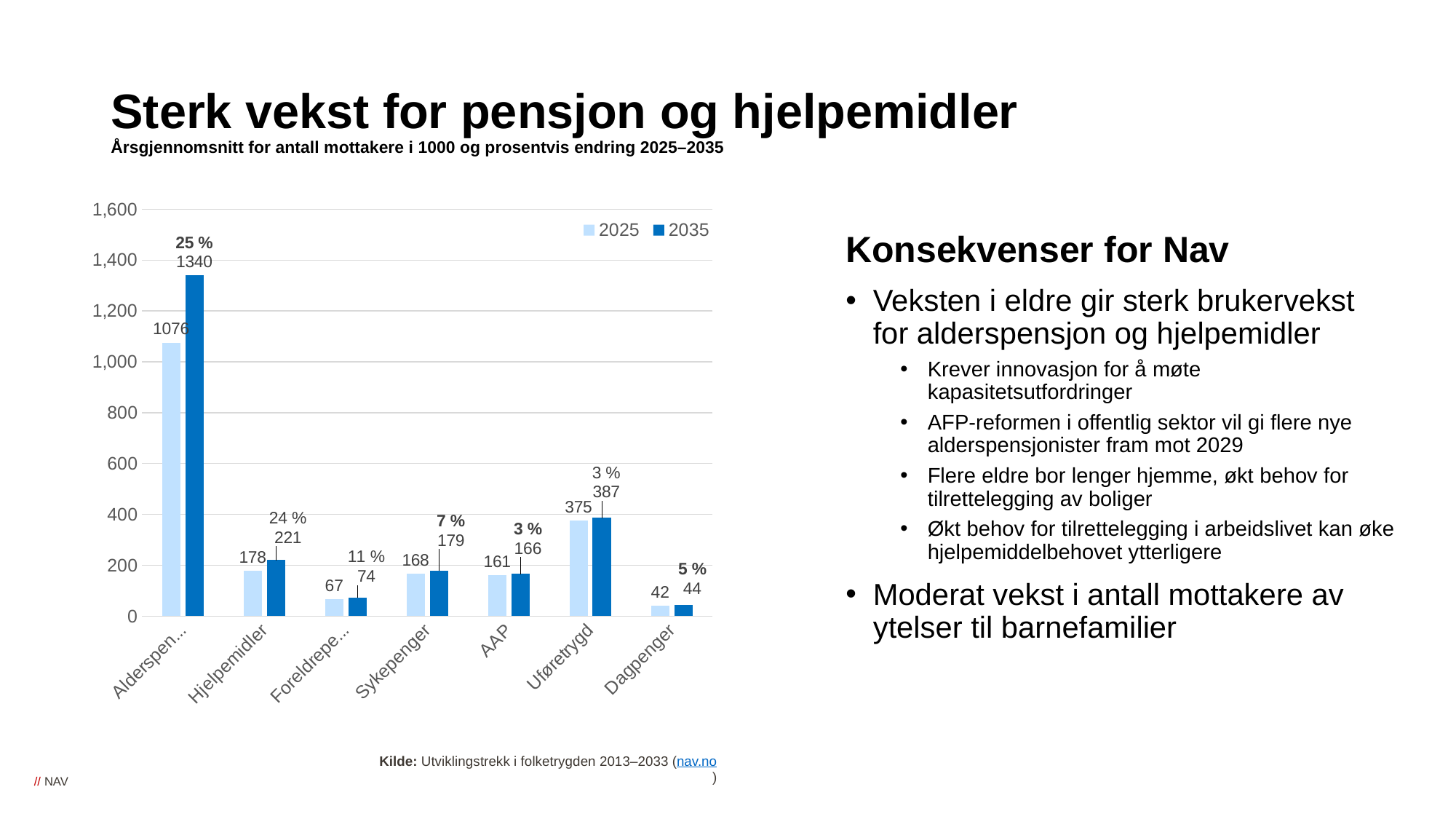
Is the 2035 value for Uføretrygd greater or less than 400? less What is the 2025 value for Uføretrygd? 375 How many series does the chart legend list? 2 Which is larger, the 2025 value for Sykepenger or the 2025 value for AAP? Sykepenger What is the 2035 value for Sykepenger? 179 What kind of chart is shown on the slide? bar chart What is the difference between the 2035 and 2025 values for Uføretrygd? 12 What is the 2035 value for Hjelpemidler? 221 What are the two series named in the chart legend? 2025 and 2035 What percentage change is shown for Hjelpemidler? 24 % How many categories are shown on the x axis of the chart? 7 Which category has the lowest 2035 value? Dagpenger